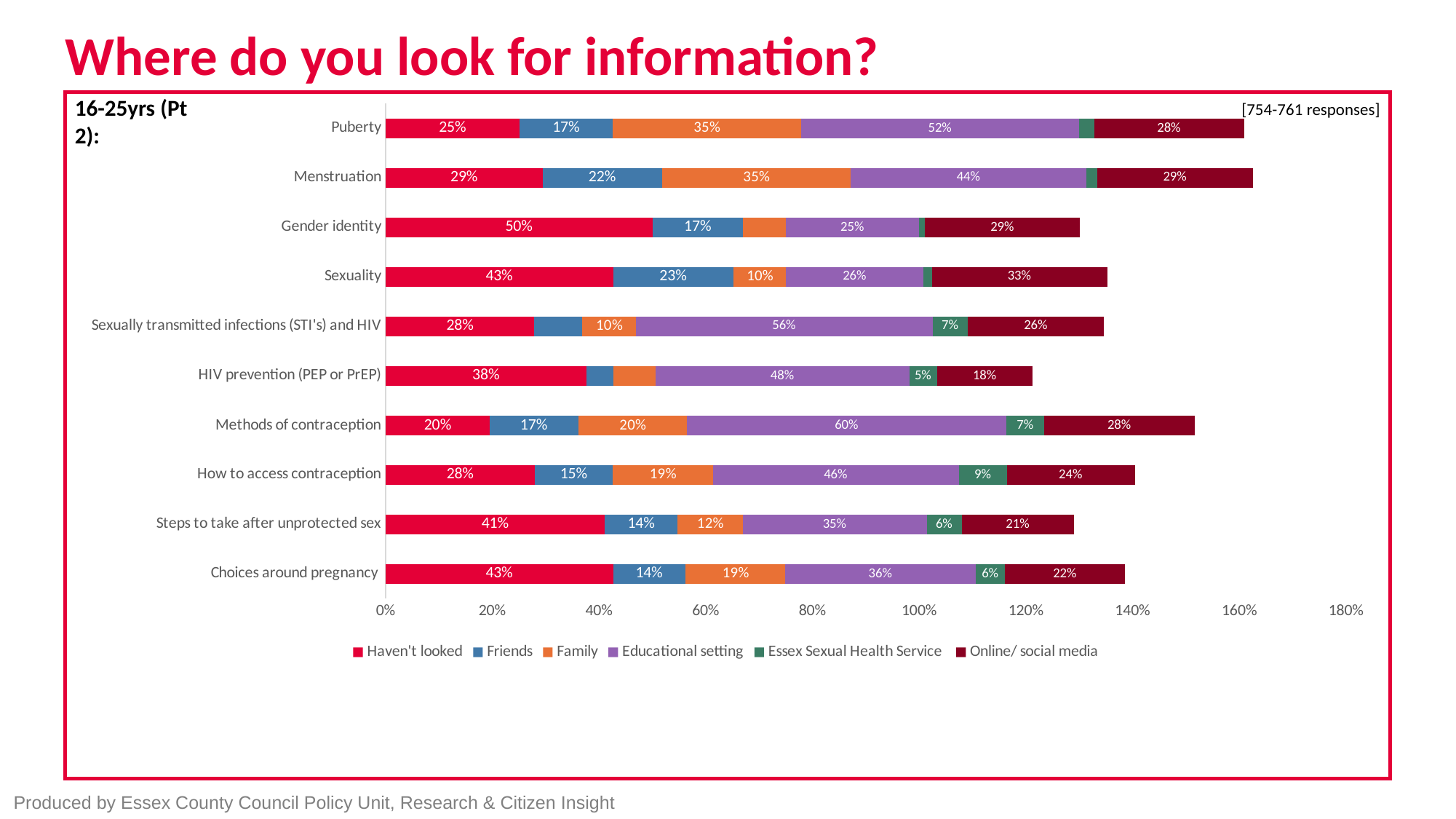
Which is larger: the 'Friends' value for Menstruation or for Puberty? Menstruation Which topic has the lowest 'Online/ social media' value? HIV prevention (PEP or PrEP) How many series does the legend list? 6 Which topic has the highest 'Haven't looked' value? Gender identity What type of chart is shown on the slide? Stacked bar chart What is the total of the stacked bar for Methods of contraception? 152% Is the total length of the Gender identity bar greater or less than 140%? less What is the 'Haven't looked' value for Gender identity? 50% What is the 'Educational setting' value for Methods of contraception? 60% What is the difference between the 'Educational setting' values for Methods of contraception and Puberty? 8% What is the 'Online/ social media' value for Sexuality? 33% How many topic categories are plotted on the chart? 10